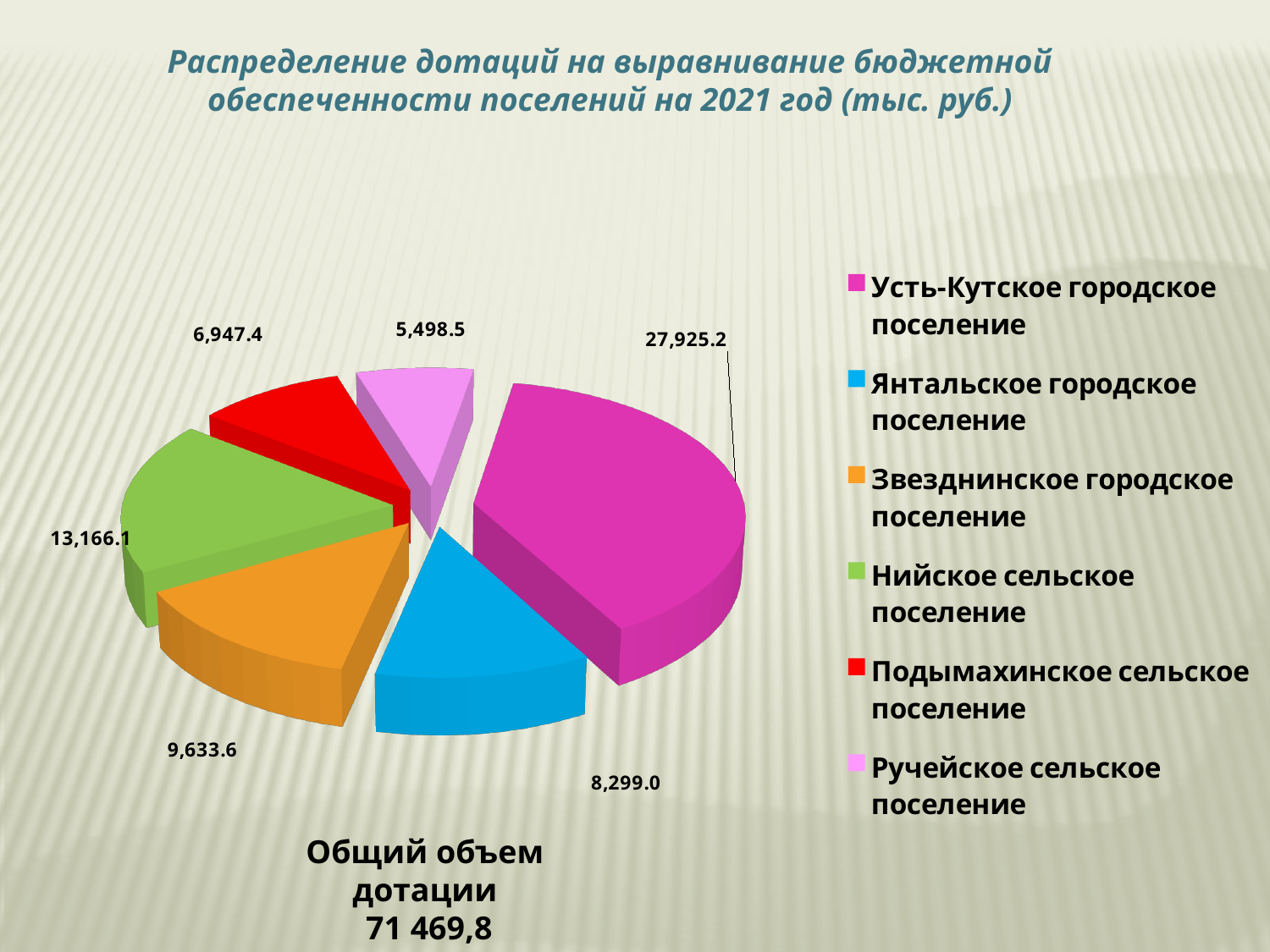
Which is larger: the value for Подымахинское сельское поселение or Янтальское городское поселение? Янтальское городское поселение Which settlement receives the smallest share of the subsidy? Ручейское сельское поселение What is the difference between the values for Усть-Кутское городское поселение and Нийское сельское поселение? 14,759.1 How many settlements (slices) are shown in the pie chart? 6 Which settlement receives the largest share of the subsidy? Усть-Кутское городское поселение What is the difference between the values for Звезднинское городское поселение and Янтальское городское поселение? 1,334.6 What type of chart is shown on the slide? pie chart What colour is the slice for Нийское сельское поселение? green What is the value for Нийское сельское поселение? 13,166.1 What is the value for Усть-Кутское городское поселение? 27,925.2 What is the value for Ручейское сельское поселение? 5,498.5 What is the value for Звезднинское городское поселение? 9,633.6